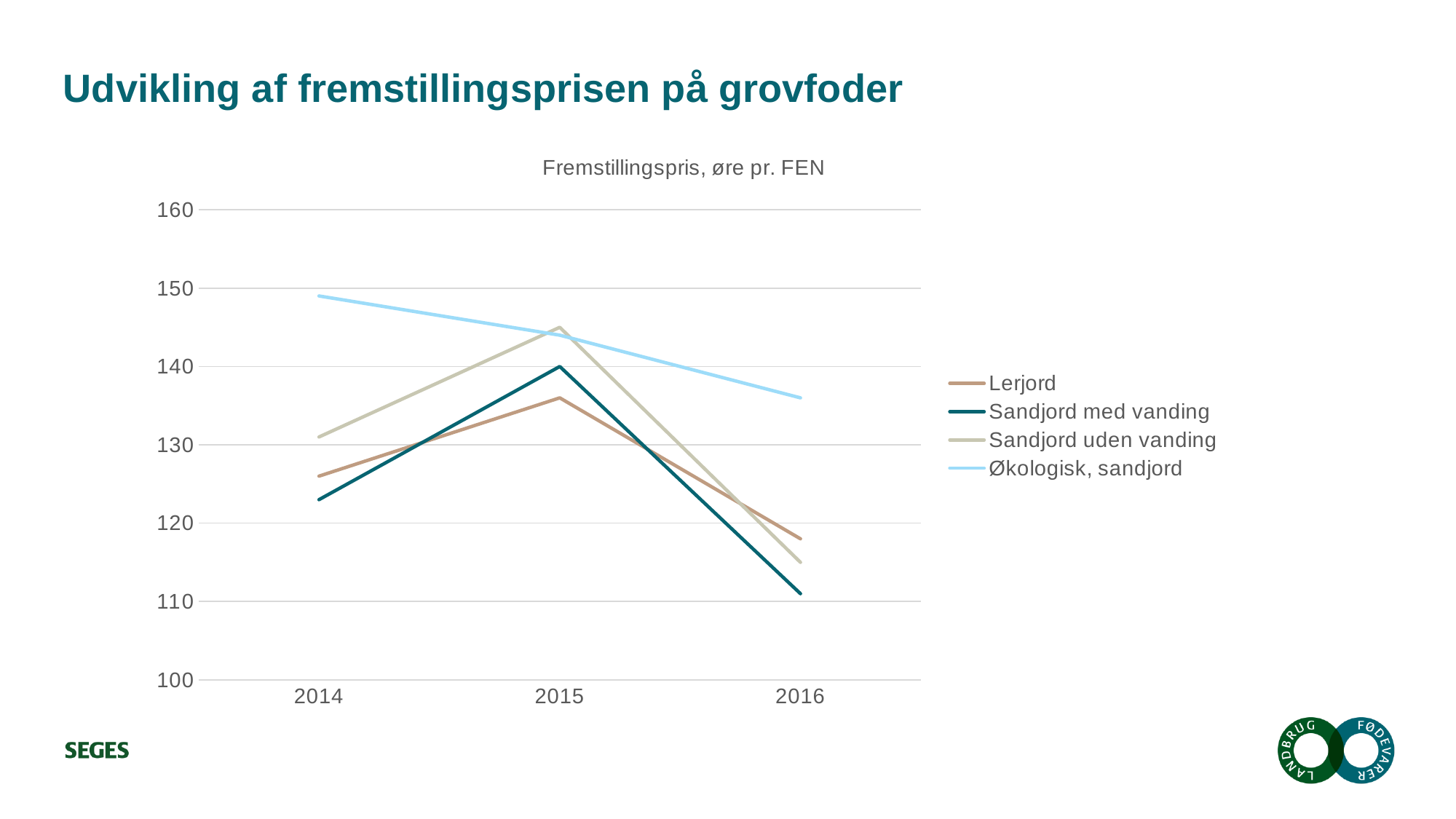
What is the title of the chart? Fremstillingspris, øre pr. FEN Which series has the highest value in 2014? Økologisk, sandjord Which series has the lowest value in 2016? Sandjord med vanding Is the value for Økologisk, sandjord in 2016 greater or less than 130? greater How many years are shown on the x axis? 3 How many series does the legend list? 4 Is the value for Økologisk, sandjord in 2014 greater or less than 140? greater Does the Økologisk, sandjord line rise or fall from 2014 to 2016? fall Is the value for Lerjord in 2014 greater or less than 130? less What kind of chart is shown on the slide? line chart In 2016, which is larger: Lerjord or Sandjord med vanding? Lerjord